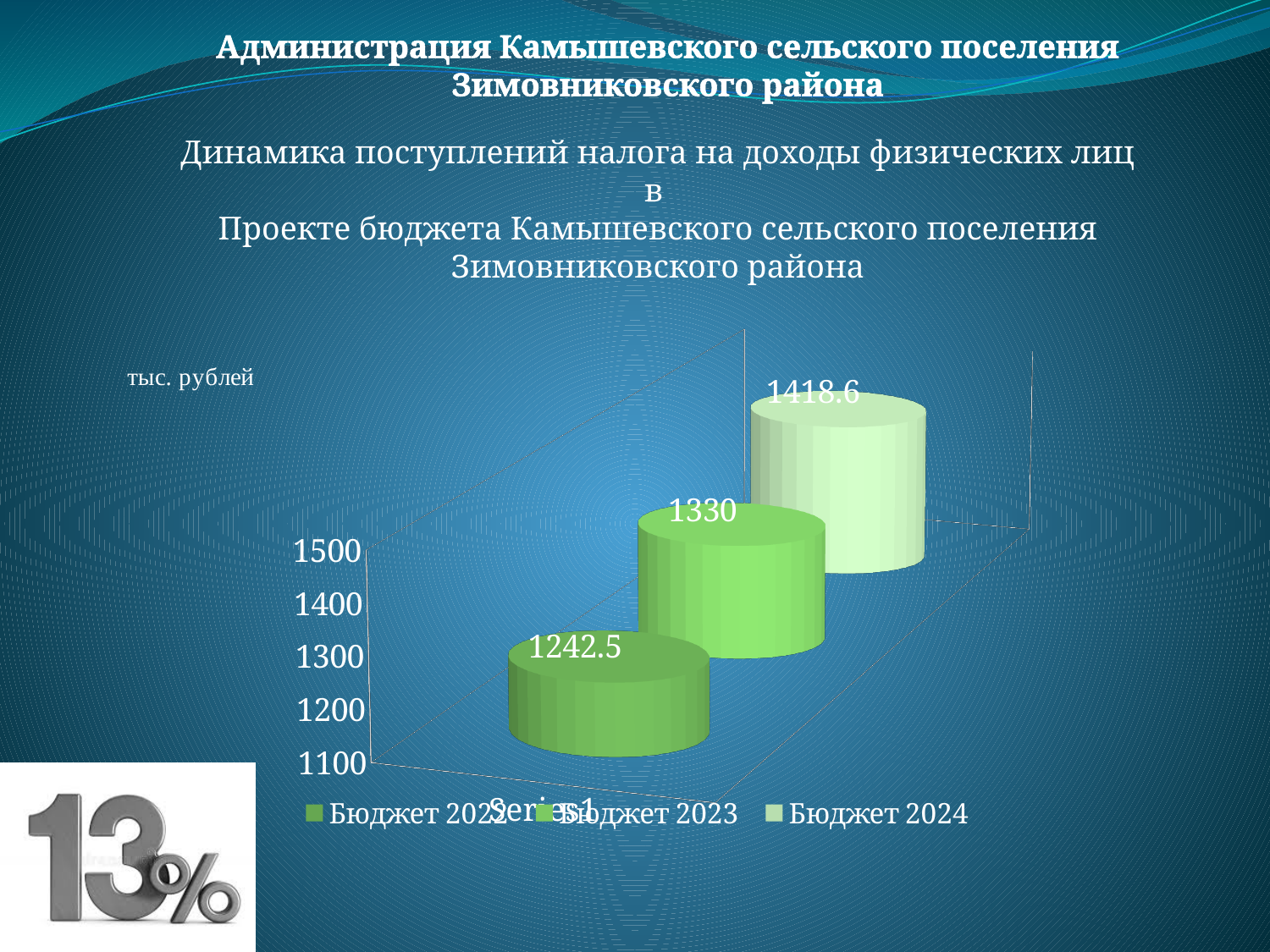
Do the values rise or fall from Бюджет 2022 to Бюджет 2024? rise Which is larger, the value for Бюджет 2023 or Бюджет 2024? Бюджет 2024 Which budget year has the highest value? Бюджет 2024 What is the value for Бюджет 2022? 1242.5 How many entries does the legend list? 3 What is the value for Бюджет 2024? 1418.6 What is the value for Бюджет 2023? 1330 What kind of chart is shown on the slide? bar chart Is the value for Бюджет 2022 greater or less than 1300? less What is the difference between the values for Бюджет 2024 and Бюджет 2022? 176.1 What is the difference between the values for Бюджет 2023 and Бюджет 2022? 87.5 Which budget year has the lowest value? Бюджет 2022